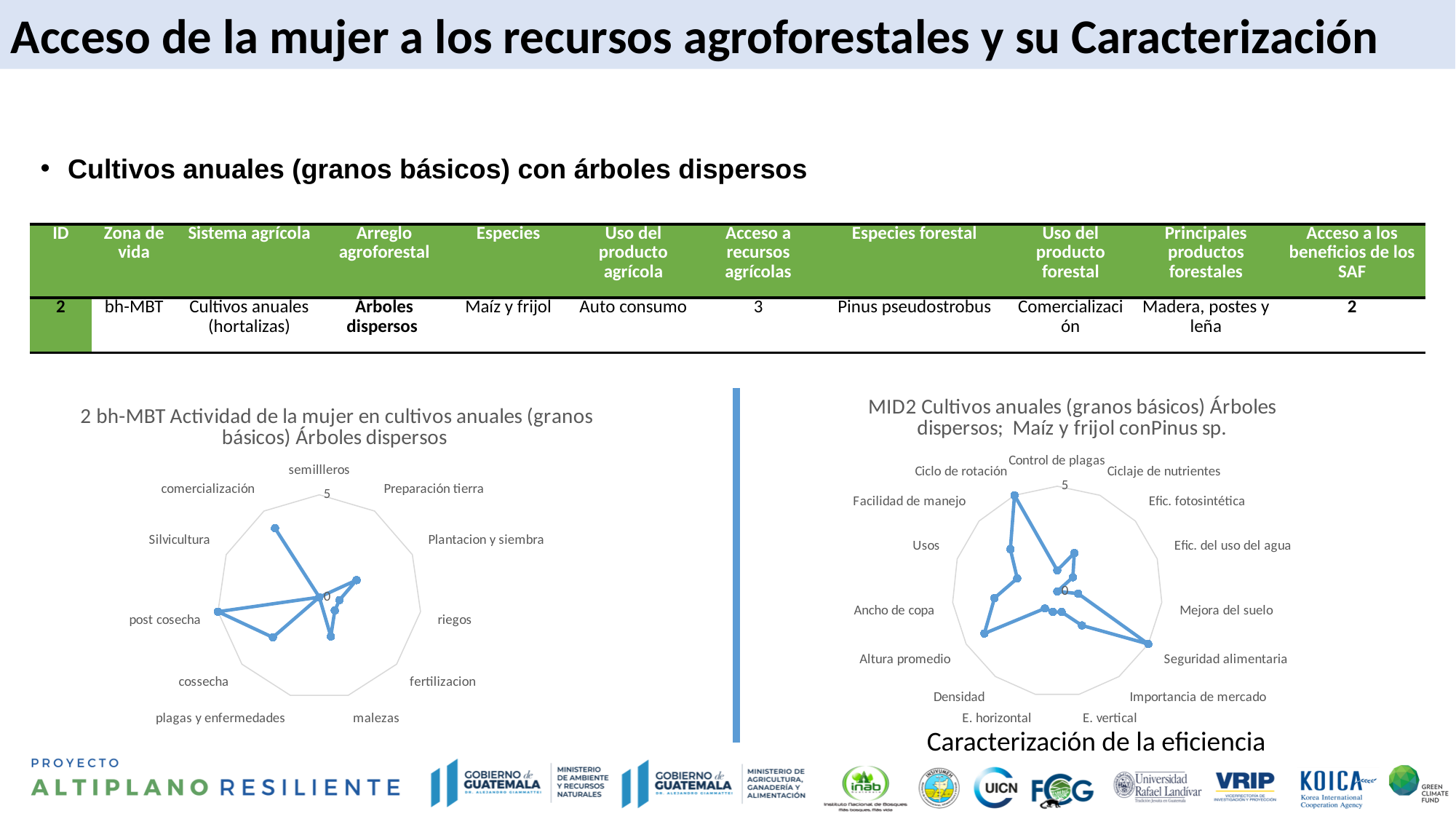
What caption appears directly below the right chart? Caracterización de la eficiencia In the left chart (2 bh-MBT Actividad de la mujer), which is larger: the value for comercialización or the value for Preparación tierra? comercialización What kind of chart is the right chart titled 'MID2 Cultivos anuales (granos básicos) Árboles dispersos; Maíz y frijol conPinus sp.'? Radar chart In the left chart (2 bh-MBT Actividad de la mujer), which category has the highest value? post cosecha What kind of chart is the left chart titled '2 bh-MBT Actividad de la mujer en cultivos anuales (granos básicos) Árboles dispersos'? Radar chart In the right chart (MID2 Cultivos anuales), which category has the highest value? Seguridad alimentaria and Ciclo de rotación (tied at 5) In the right chart (MID2 Cultivos anuales), which is larger: the value for Control de plagas or the value for Ciclaje de nutrientes? Ciclaje de nutrientes In the right chart (MID2 Cultivos anuales), which is larger: the value for Seguridad alimentaria or the value for Mejora del suelo? Seguridad alimentaria What is the maximum tick value shown on the radial axis of the left chart (2 bh-MBT Actividad de la mujer)? 5 In the right chart (MID2 Cultivos anuales), how many categories are plotted around the radar? 15 In the left chart (2 bh-MBT Actividad de la mujer), how many categories are plotted around the radar? 11